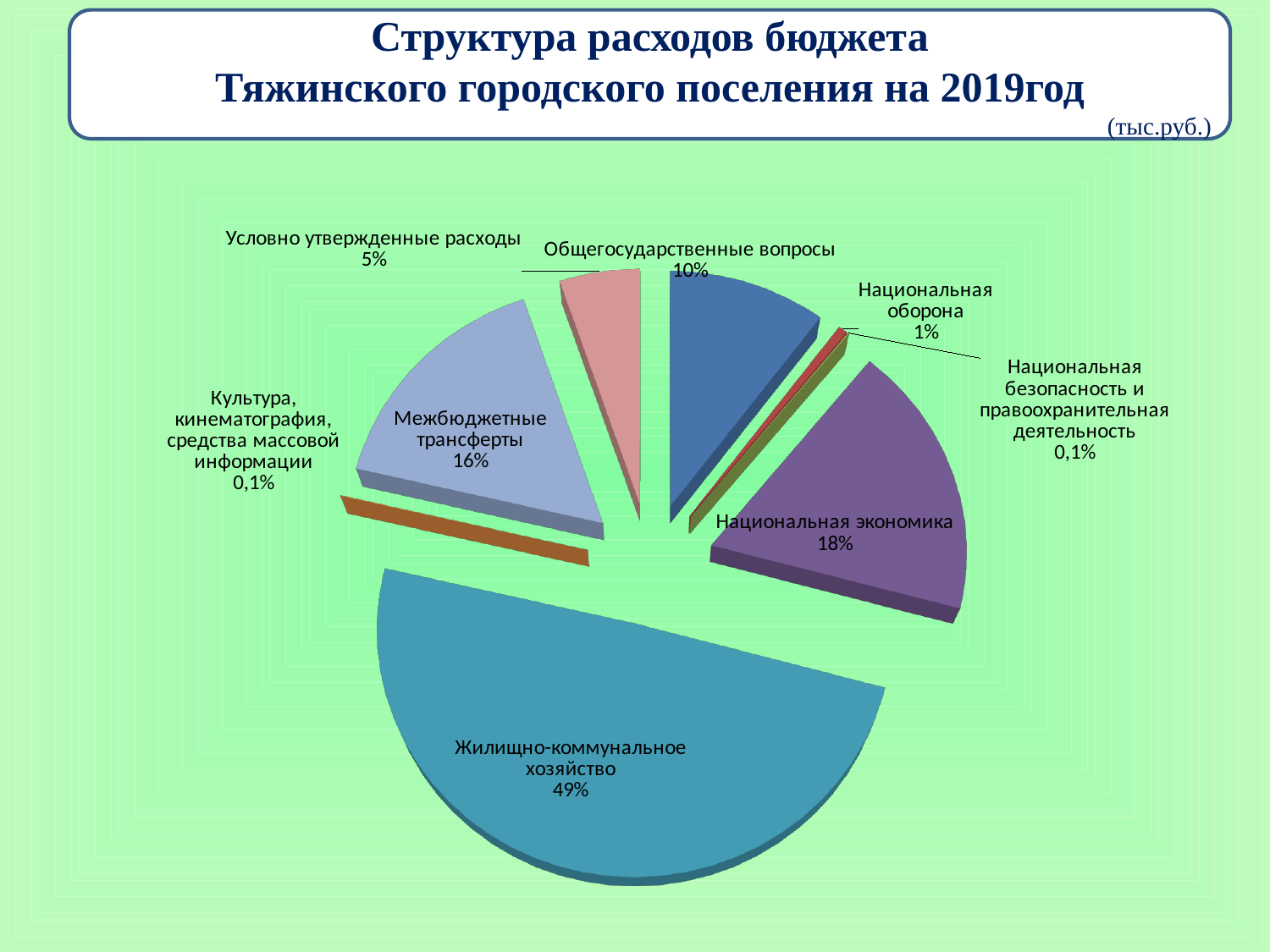
What percentage is shown for Условно утвержденные расходы? 5% What kind of chart is shown on the slide? pie chart What percentage is shown for Общегосударственные вопросы? 10% How many categories (slices) does the pie chart have? 8 What percentage is shown for Национальная экономика? 18% What share of the budget expenditure goes to Жилищно-коммунальное хозяйство? 49% What percentage is shown for Национальная оборона? 1% What percentage is shown for Межбюджетные трансферты? 16% What is the difference in percentage points between Национальная экономика and Межбюджетные трансферты? 2% Which is larger: the share for Общегосударственные вопросы or the share for Условно утвержденные расходы? Общегосударственные вопросы Which category has the largest share of the pie? Жилищно-коммунальное хозяйство What year does the chart title say the budget expenditure structure is for? 2019